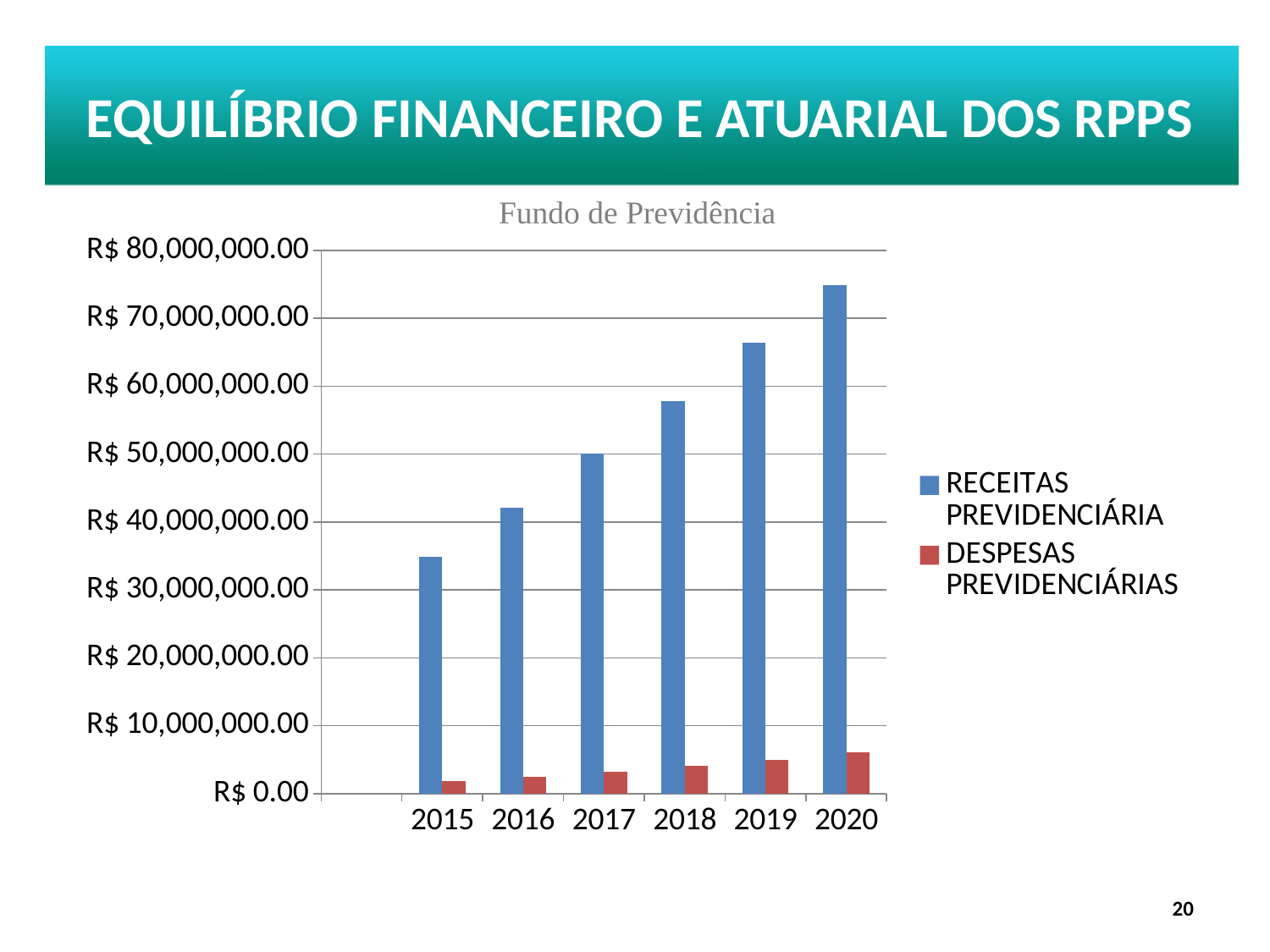
Is the value for RECEITAS PREVIDENCIÁRIA in 2020 greater or less than R$ 70,000,000.00? greater Is the value for RECEITAS PREVIDENCIÁRIA in 2015 greater or less than R$ 30,000,000.00? greater In 2019, which series has the larger value, RECEITAS PREVIDENCIÁRIA or DESPESAS PREVIDENCIÁRIAS? RECEITAS PREVIDENCIÁRIA What kind of chart is shown on the slide? bar chart Is the value for DESPESAS PREVIDENCIÁRIAS in 2020 greater or less than R$ 10,000,000.00? less Do the values for RECEITAS PREVIDENCIÁRIA rise or fall from 2015 to 2020? rise Which year has the lowest value for DESPESAS PREVIDENCIÁRIAS? 2015 Which year has the highest value for RECEITAS PREVIDENCIÁRIA? 2020 How many series does the legend list? 2 What is the title of the chart? Fundo de Previdência How many years are shown on the x axis? 6